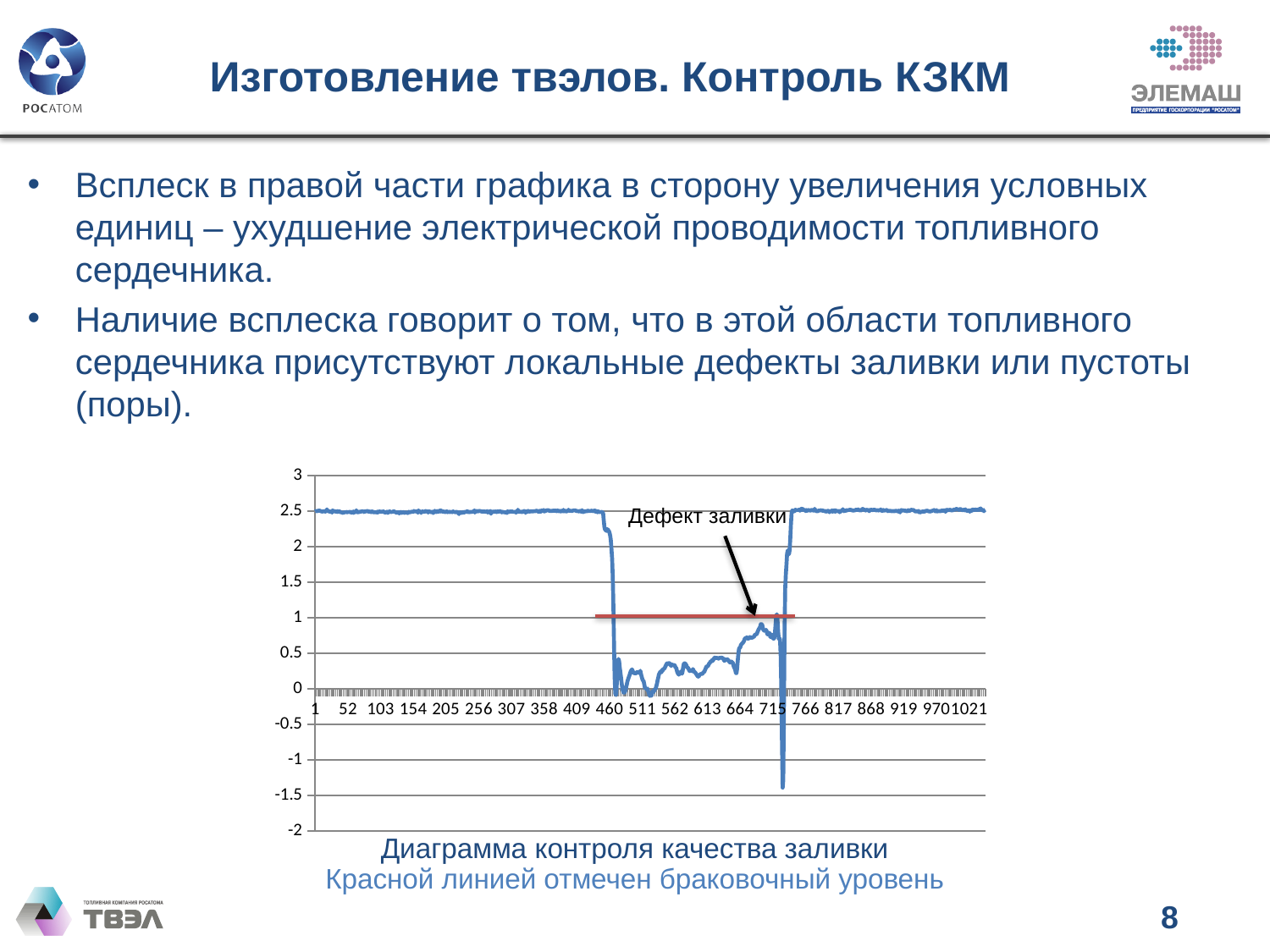
Is the level of the red horizontal line greater or less than 0.5? greater Is the value of the blue line at x = 256 greater or less than 1.5? greater What kind of chart is shown on the slide? line chart Which is larger: the value of the blue line at x = 1 or at x = 562? x = 1 What text does the arrow annotation on the chart point with? Дефект заливки Is the value of the blue line at x = 1021 greater or less than 2? greater What does the red line on the chart mark, according to the caption? браковочный уровень Does the blue line rise or fall between x = 409 and x = 511? fall